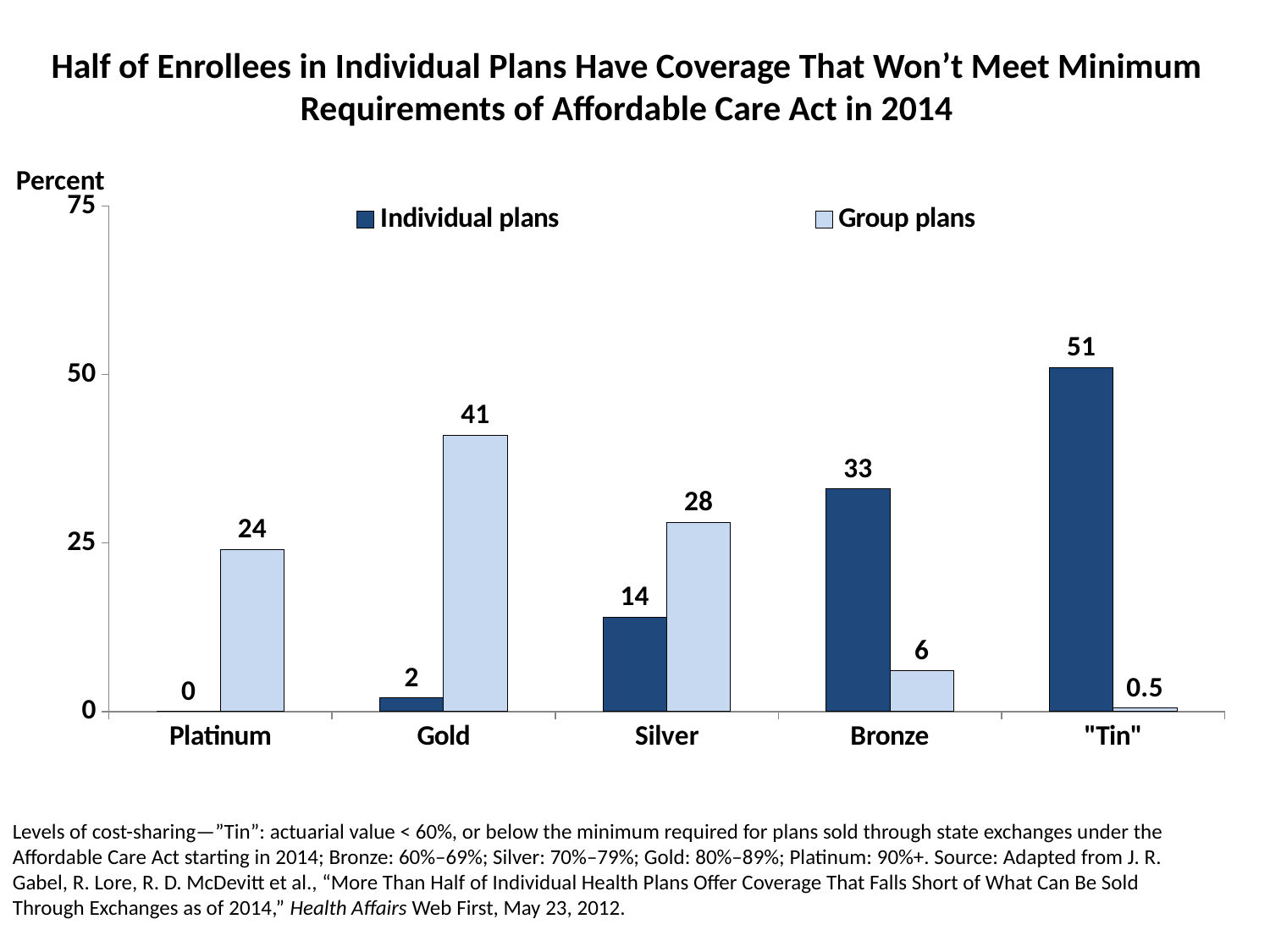
Is the value for Group plans in the Gold category greater or less than 50? less Which category has the lowest value for Group plans? "Tin" What is the difference between Group plans and Individual plans in the Silver category? 14 Which is larger in the Bronze category, Individual plans or Group plans? Individual plans What is the value for Group plans in the "Tin" category? 0.5 What is the label on the y axis? Percent How many series does the legend list? 2 How many categories are shown on the x axis? 5 Which category has the highest value for Individual plans? "Tin" What is the value for Group plans in the Gold category? 41 What kind of chart is shown on the slide? Bar chart What is the value for Individual plans in the "Tin" category? 51